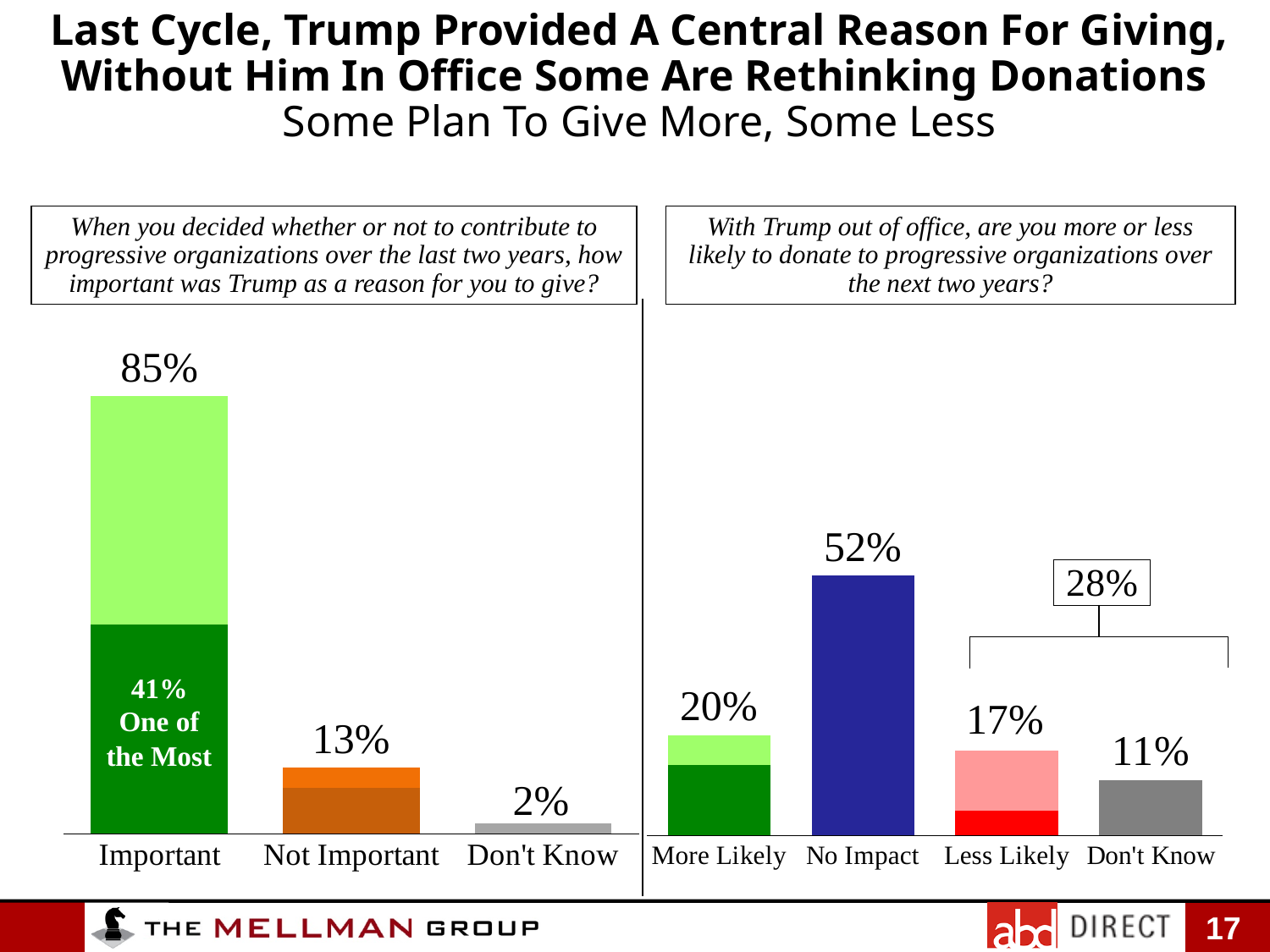
In the right chart, what percentage said No Impact? 52% In the left chart, what is the difference between the Important and Not Important values? 72 percentage points In the right chart, which category has the highest value? No Impact In the left chart, what percentage said Trump was Important as a reason to give? 85% In the left chart, which category has the lowest value? Don't Know In the right chart, what percentage said they are Less Likely to donate? 17% In the right chart, what combined percentage is shown by the bracket over Less Likely and Don't Know? 28% In the right chart, which is larger, More Likely or Less Likely? More Likely In the left chart, what share said Trump was One of the Most important reasons to give? 41% In the left chart, what percentage said Trump was Not Important as a reason to give? 13% How many categories are shown in the right chart? 4 In the right chart, what percentage said they are More Likely to donate? 20%